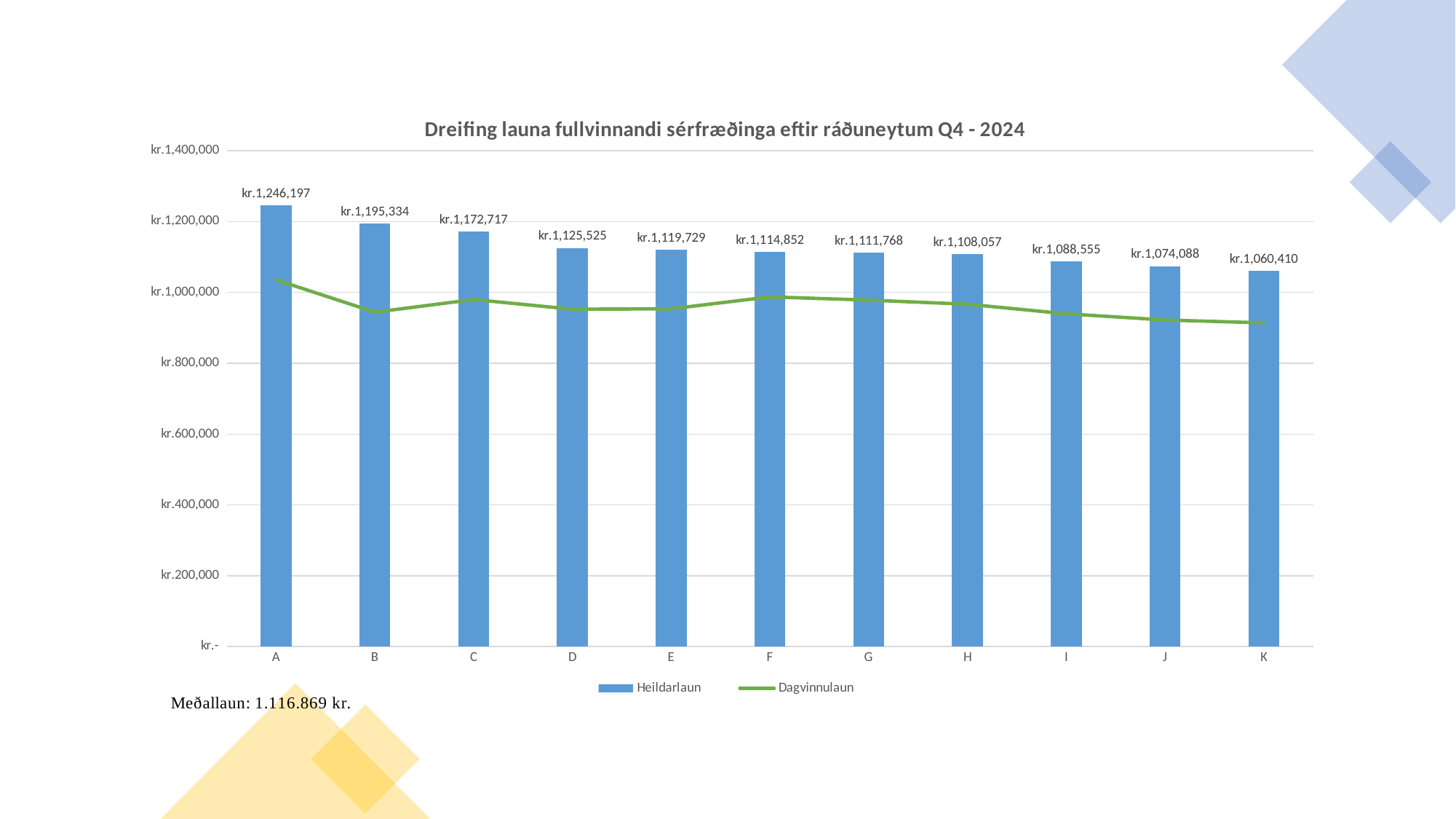
What is the difference in Heildarlaun between ministry A and ministry K? kr.185,787 How many series does the legend list? 2 Is the Dagvinnulaun value for ministry K greater or less than kr.1,000,000? less Which ministry has the highest Heildarlaun? A What kind of chart is shown on the slide? Bar chart with a line How many ministries are shown on the x axis? 11 Which ministry has the lowest Heildarlaun? K What is the Heildarlaun value for ministry F? kr.1,114,852 What is the Heildarlaun value for ministry K? kr.1,060,410 Which has the larger Heildarlaun, ministry D or ministry H? D What is the Heildarlaun value for ministry A? kr.1,246,197 Do the Heildarlaun values rise or fall from A to K? Fall